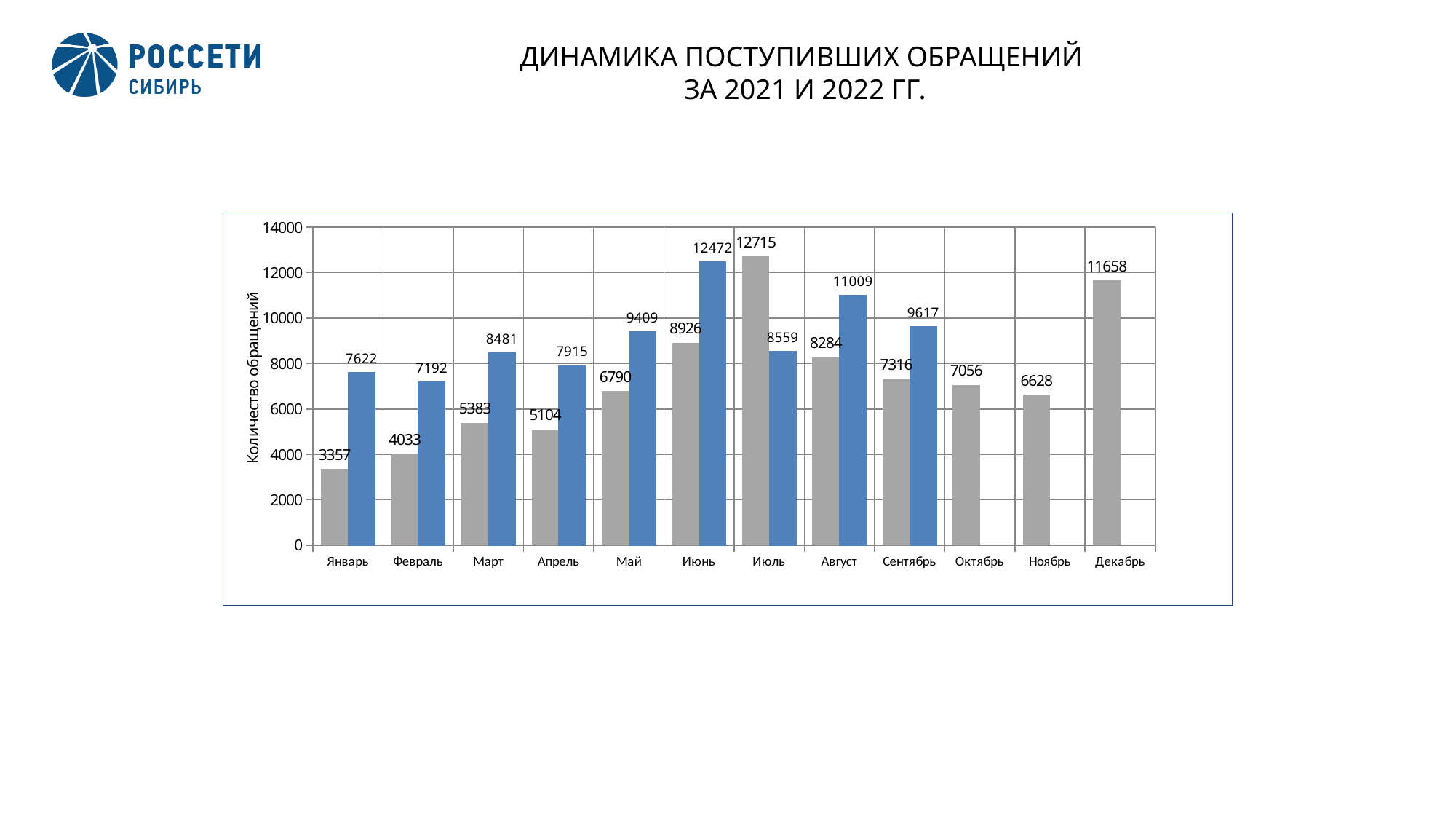
What is the label of the vertical axis? Количество обращений Which month has the lowest gray bar? Январь What type of chart is shown on the slide? bar chart Which month has the highest blue bar? Июнь What is the value of the gray bar for Январь? 3357 Which is larger for Июль, the gray bar or the blue bar? the gray bar What is the difference between the blue bar and the gray bar for Январь? 4265 How many months are shown on the x axis? 12 Which month has the highest gray bar? Июль What is the value of the blue bar for Июнь? 12472 How many months have a blue bar? 9 What is the value of the gray bar for Декабрь? 11658